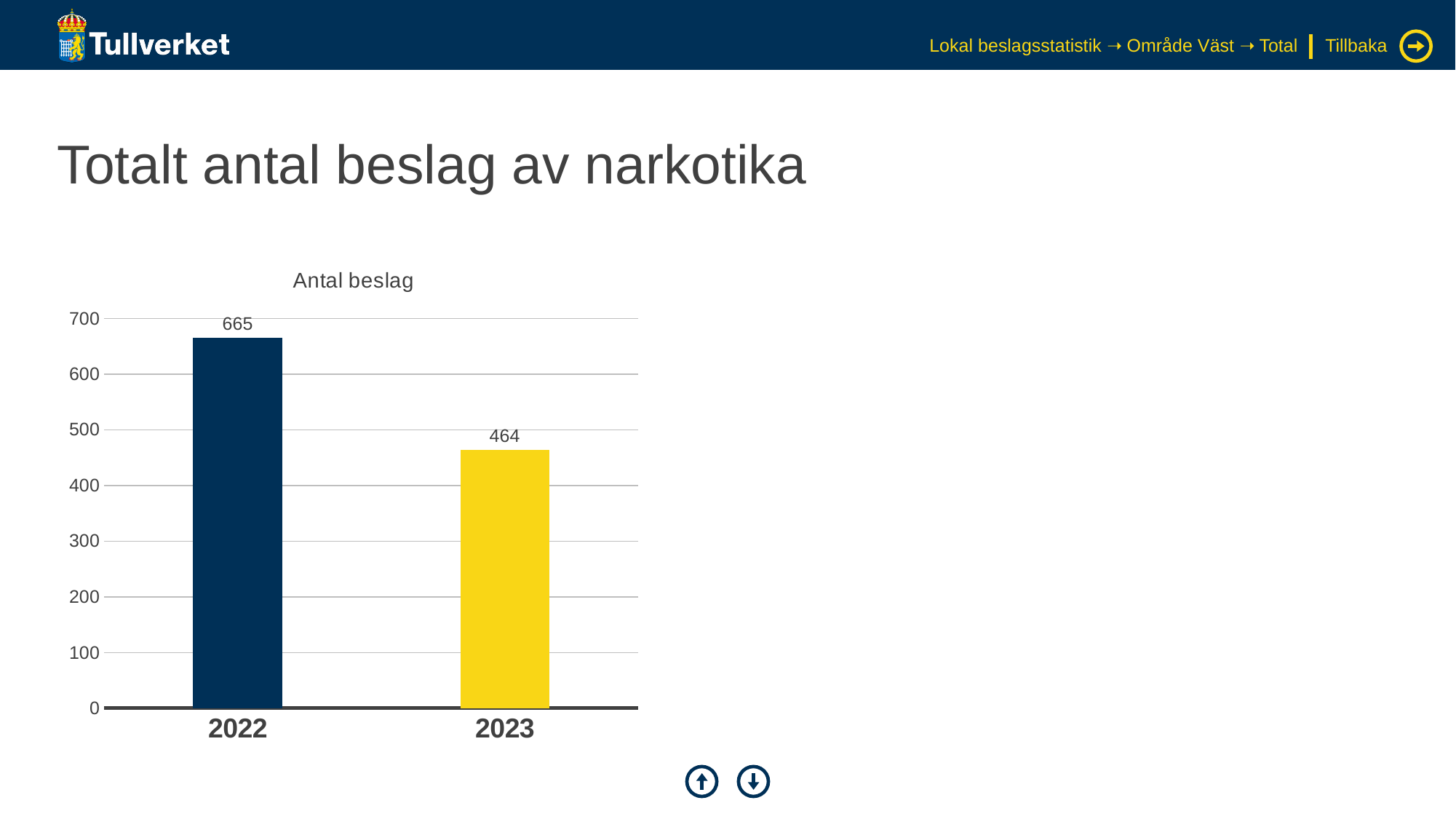
Is the value for 2023 greater or less than 500? less What kind of chart is shown on the slide? bar chart Which is larger, the value for 2022 or the value for 2023? 2022 Do the values rise or fall from 2022 to 2023? fall What is the value for 2022 in the Antal beslag chart? 665 How many years are shown on the x axis of the chart? 2 What is the title of the chart? Antal beslag What is the difference between the values for 2022 and 2023? 201 Is the value for 2022 greater or less than 600? greater Which year has the highest value in the Antal beslag chart? 2022 What is the value for 2023 in the Antal beslag chart? 464 Which year has the lowest value in the Antal beslag chart? 2023